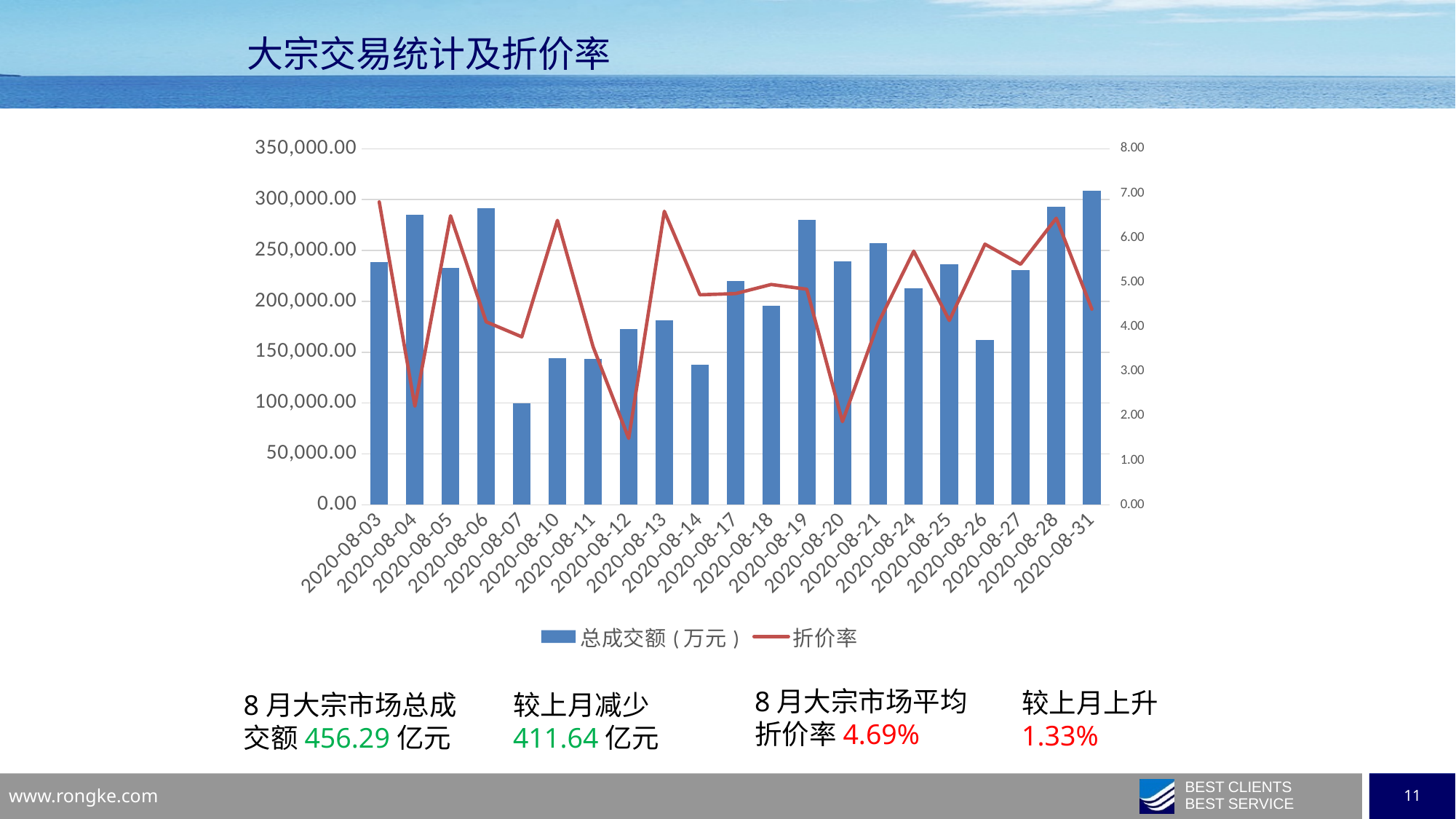
Which date has the lowest 总成交额 bar? 2020-08-07 What is the title of the slide containing the chart? 大宗交易统计及折价率 On which date does the 折价率 line reach its lowest point? 2020-08-12 Is the 总成交额 value for 2020-08-04 greater or less than 250,000.00? greater Which date has the highest 总成交额 bar? 2020-08-31 How many dates are shown on the x axis of the chart? 21 How many series does the chart legend list? 2 What kind of chart is shown on the slide? A combination bar and line chart Which is larger, the 总成交额 bar for 2020-08-19 or for 2020-08-18? 2020-08-19 Is the 折价率 value for 2020-08-03 greater or less than 6.00? greater Is the 总成交额 value for 2020-08-26 greater or less than 200,000.00? less